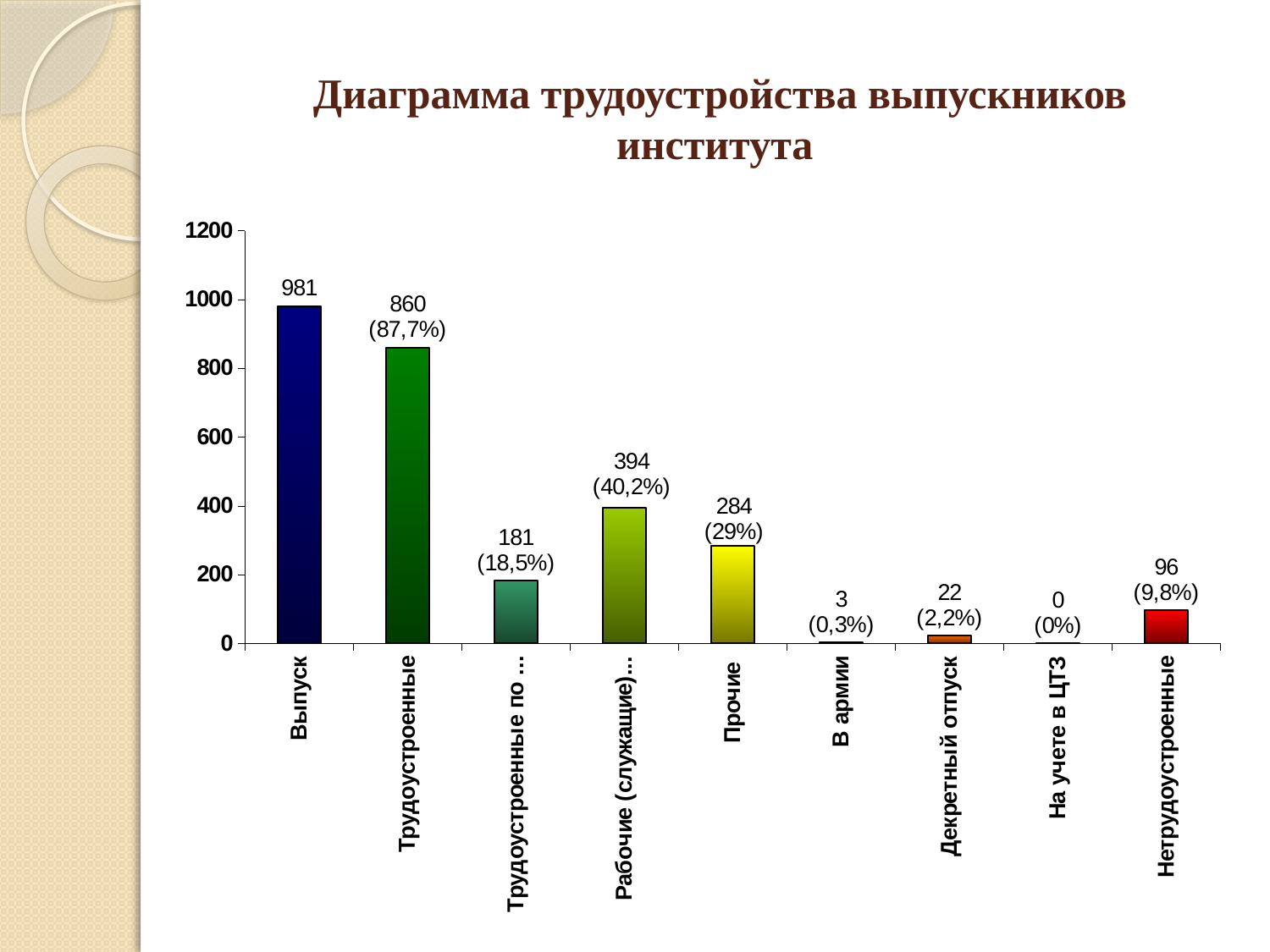
What is the value for Выпуск? 981 What is the value for Прочие? 284 Which category has the lowest value? На учете в ЦТЗ What percentage is shown for Трудоустроенные? 87,7% What is the value for Декретный отпуск? 22 What kind of chart is shown on the slide? bar chart What is the difference between the values for Выпуск and Трудоустроенные? 121 What is the value for Трудоустроенные? 860 Which is larger, the value for Прочие or the value for Нетрудоустроенные? Прочие What is the value for Нетрудоустроенные? 96 How many categories are shown on the x axis? 9 Which category has the highest value? Выпуск